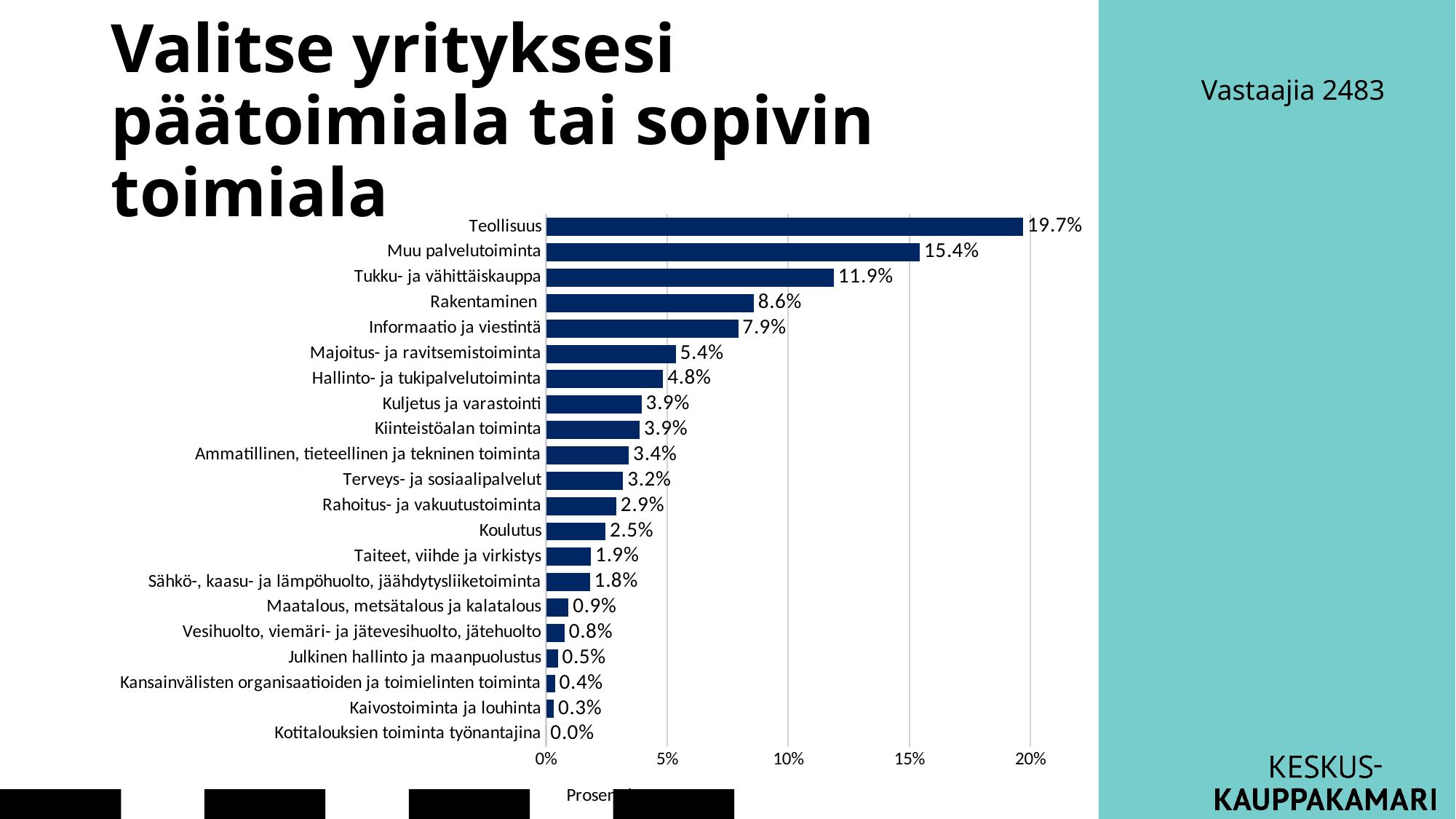
Is the value for Tukku- ja vähittäiskauppa greater or less than 10%? greater What kind of chart is shown on the slide? bar chart How many categories are shown in the chart? 21 What is the value for Koulutus? 2.5% Which category has the lowest value? Kotitalouksien toiminta työnantajina What is the number of respondents (Vastaajia) shown on the slide? 2483 What is the value for Teollisuus? 19.7% What is the value for Rakentaminen? 8.6% Which category has the highest value? Teollisuus What is the difference between the values for Teollisuus and Muu palvelutoiminta? 4.3% Which is larger, the value for Informaatio ja viestintä or the value for Majoitus- ja ravitsemistoiminta? Informaatio ja viestintä What is the value for Kaivostoiminta ja louhinta? 0.3%